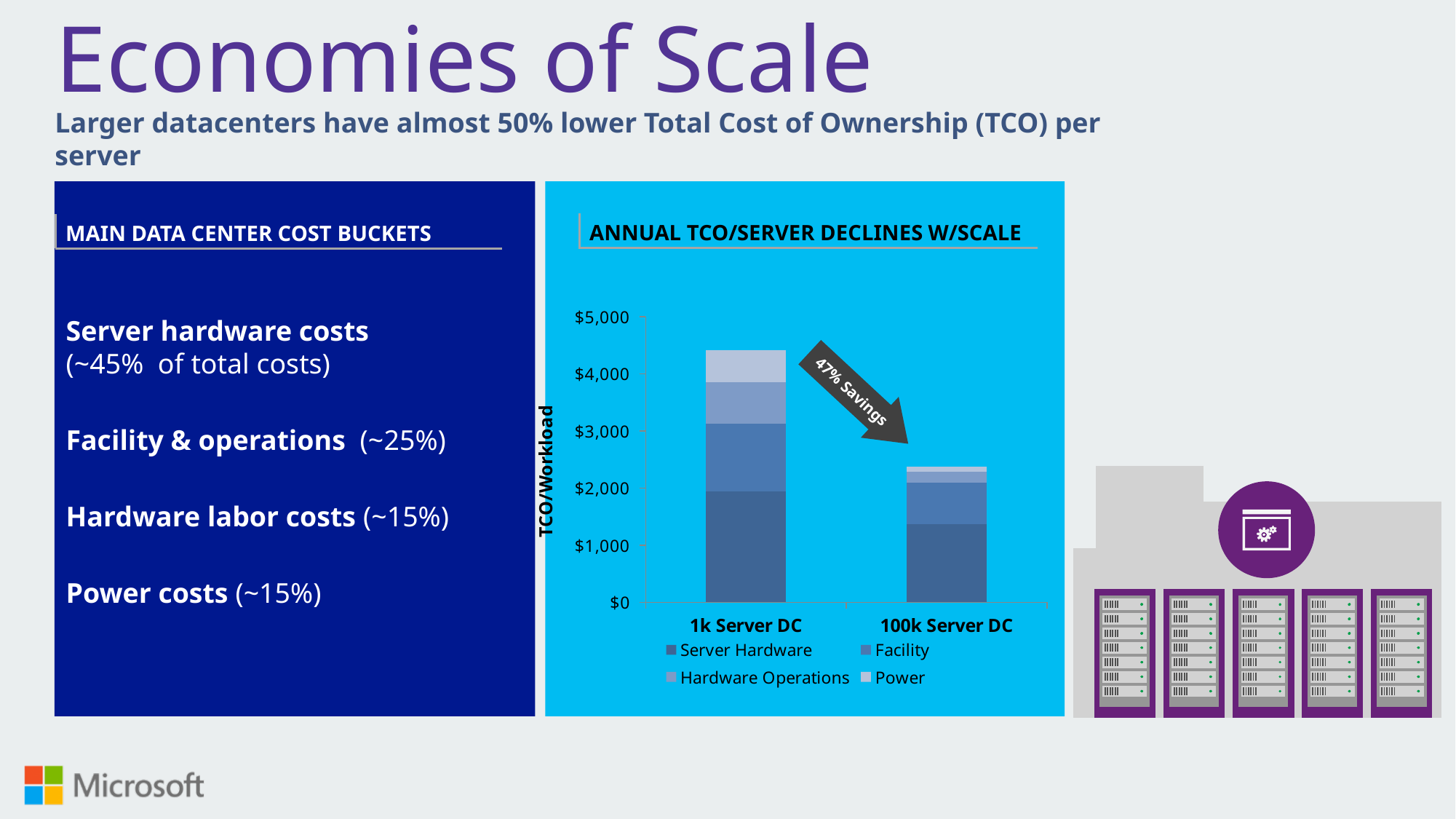
Which category has the higher total annual TCO per server? 1k Server DC How many series does the chart legend list? 4 Is the total value for 100k Server DC greater or less than $2,000? greater What savings percentage is written on the arrow between the two bars? 47% Savings Is the total value for 1k Server DC greater or less than $4,000? greater What is the title of the chart? ANNUAL TCO/SERVER DECLINES W/SCALE What kind of chart is shown on the slide? Stacked bar chart How many categories are shown on the x axis of the chart? 2 Do the bar totals rise or fall from 1k Server DC to 100k Server DC? fall Is the total value for 100k Server DC greater or less than $3,000? less Which category has the lower total annual TCO per server? 100k Server DC